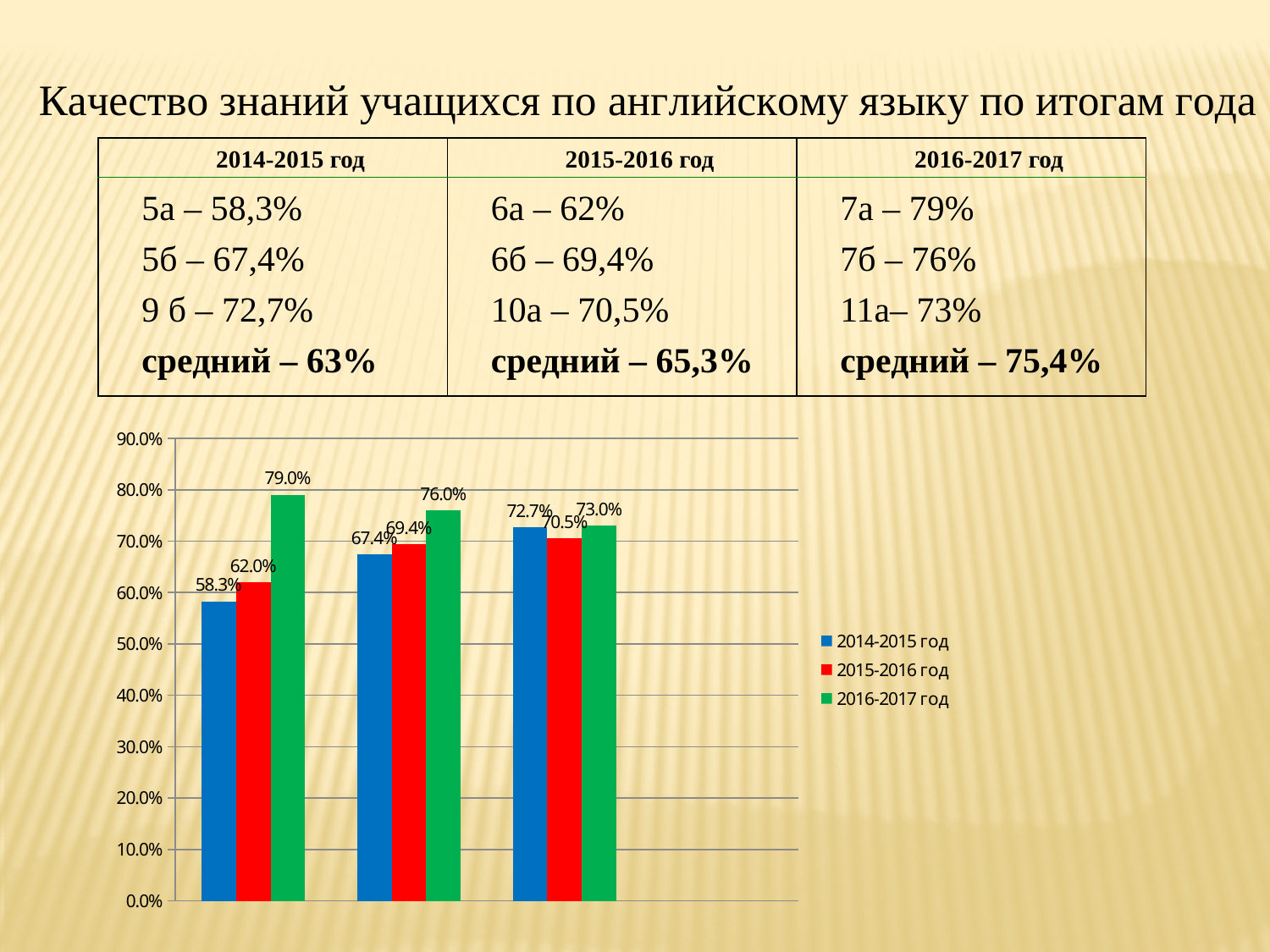
What is the value of the 2016-2017 год bar in the first (leftmost) group of bars? 79.0% What is the value of the 2015-2016 год bar in the third (rightmost) group of bars? 70.5% How many series does the chart legend list? 3 How many groups of bars are plotted in the chart? 3 What kind of chart is shown on the slide? bar chart What is the difference between the 2016-2017 год bar and the 2014-2015 год bar in the first (leftmost) group? 20.7% Which colour represents the 2015-2016 год series in the chart? red What is the value of the 2014-2015 год bar in the second (middle) group of bars? 67.4% Which series has the lowest bar in the first (leftmost) group? 2014-2015 год Which series has the highest bar in the first (leftmost) group? 2016-2017 год In the second (middle) group, which is larger: the 2015-2016 год bar or the 2016-2017 год bar? 2016-2017 год Is the value of the 2014-2015 год bar in the first (leftmost) group greater or less than 60.0%? less